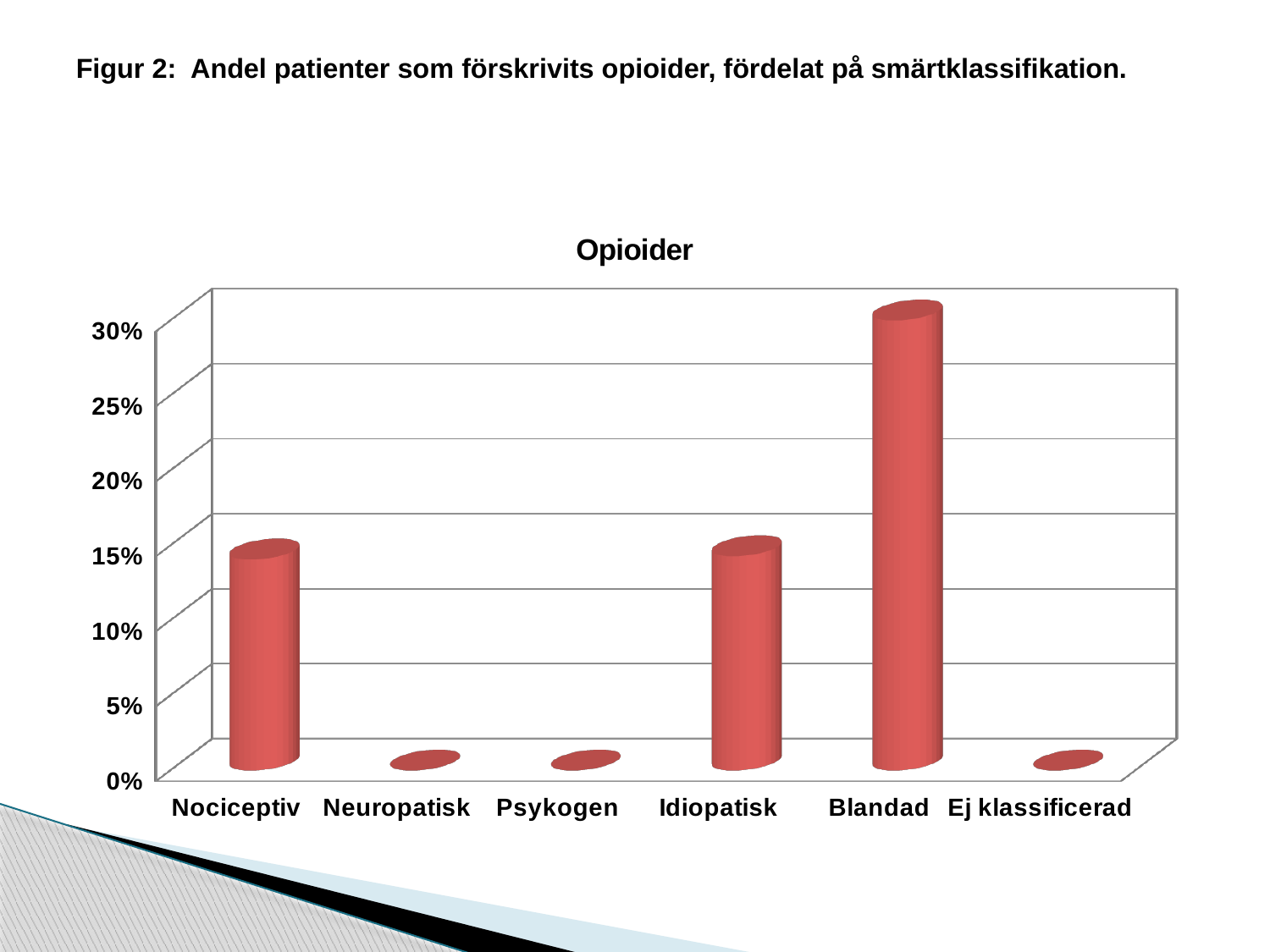
What is the title of the chart? Opioider Is the value for Idiopatisk greater or less than 5%? greater Which is larger, the value for Idiopatisk or the value for Psykogen? Idiopatisk Is the value for Blandad greater or less than 25%? greater How many categories are shown on the x axis of the chart? 6 Which category has the highest value in the chart? Blandad Is the value for Nociceptiv greater or less than 10%? greater Which is larger, the value for Blandad or the value for Nociceptiv? Blandad What kind of chart is shown on the slide? Bar chart